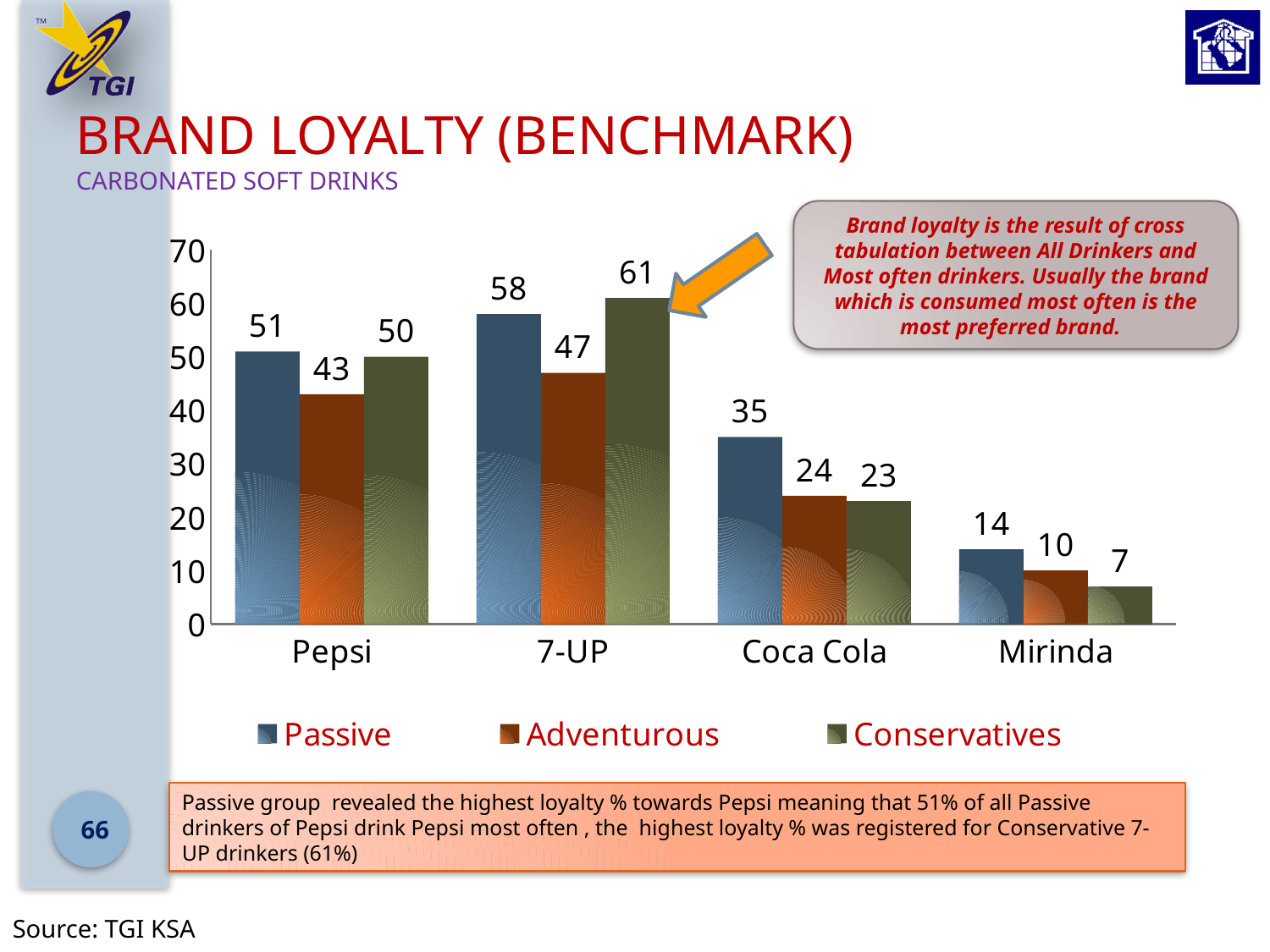
Which brand has the lowest Conservatives value? Mirinda What is the subtitle shown under the slide title? CARBONATED SOFT DRINKS What is the difference between the Passive and Adventurous values for Pepsi? 8 Which is larger for Coca Cola, the Passive value or the Conservatives value? Passive What kind of chart is shown on the slide? Bar chart How many brands are shown on the x axis? 4 Do the Adventurous values rise or fall from 7-UP to Mirinda? Fall Which brand has the highest Passive value? 7-UP How many series does the legend list? 3 What is the Conservatives value for 7-UP? 61 What is the Adventurous value for Coca Cola? 24 What is the Passive value for Pepsi? 51